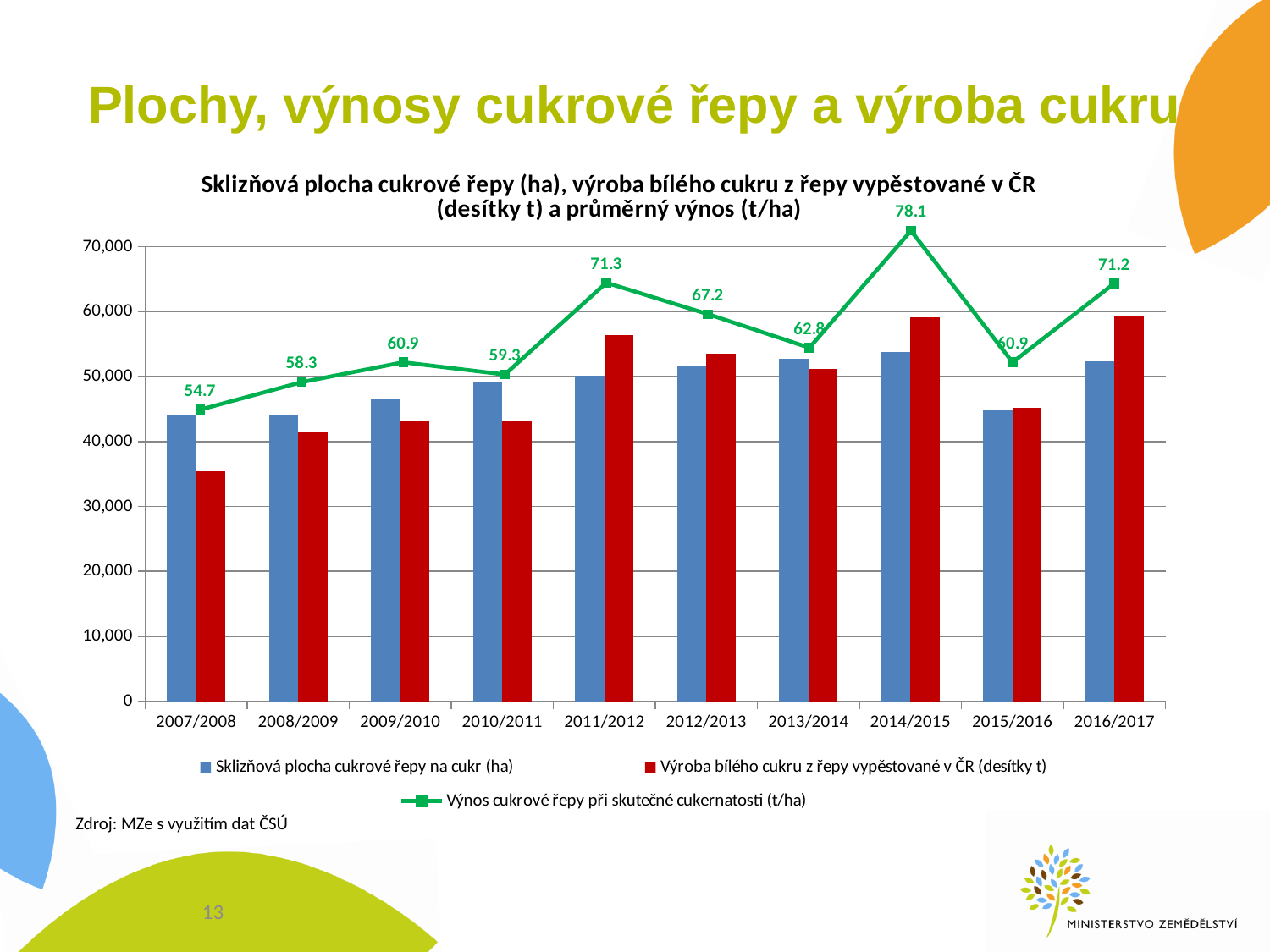
What is the difference between the yield line values for 2014/2015 and 2007/2008? 23.4 What is the value of the yield line for 2007/2008? 54.7 What is the value of the yield line (Výnos cukrové řepy při skutečné cukernatosti) for 2014/2015? 78.1 How many seasons are shown on the x axis? 10 What kind of chart is shown on the slide? a combined bar and line chart In which season is the yield line (t/ha) at its highest? 2014/2015 For 2016/2017, which bar is taller: the blue bar (Sklizňová plocha) or the red bar (Výroba bílého cukru)? the red bar (Výroba bílého cukru) What is the value of the yield line for 2011/2012? 71.3 How many series does the legend list? 3 In which season is the yield line (t/ha) at its lowest? 2007/2008 Is the value of the red bar (Výroba bílého cukru) for 2007/2008 greater or less than 40,000? less Is the value of the blue bar (Sklizňová plocha) for 2015/2016 greater or less than 50,000? less